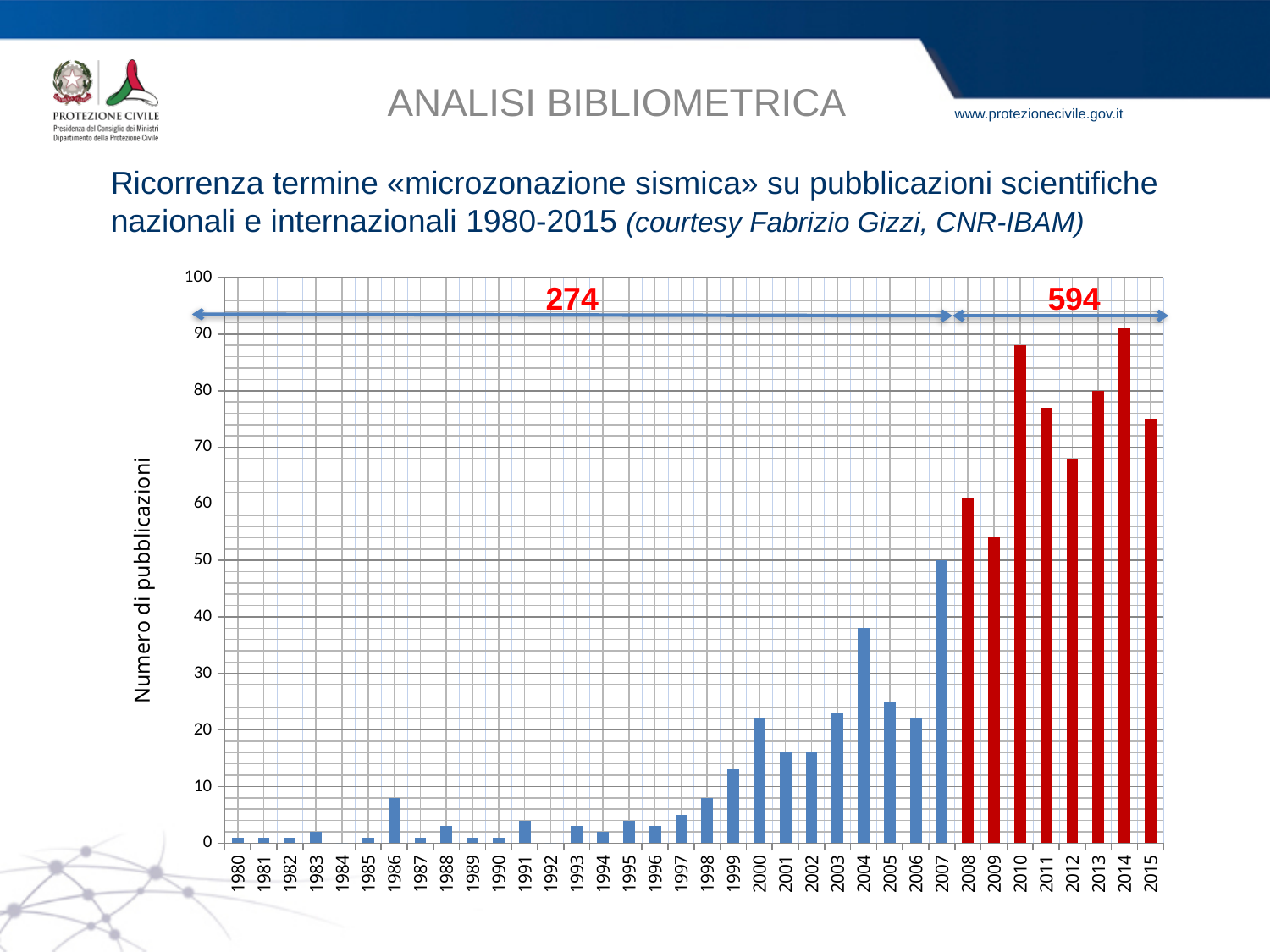
Is the value for 2012 greater or less than 70? less What total is annotated above the blue bars for the period 1980-2007? 274 Is the value for 1986 greater or less than 10? less Which is larger, the value for 2008 or the value for 2009? 2008 Is the value for 2004 greater or less than 30? greater What is the label of the y axis? Numero di pubblicazioni Which is larger, the value for 2010 or the value for 2011? 2010 What is the value for 2007? 50 Do the values generally rise or fall from 1980 to 2015? rise How many years (categories) are plotted on the x axis? 36 Which year has the highest number of publications? 2014 What kind of chart is shown on the slide? bar chart